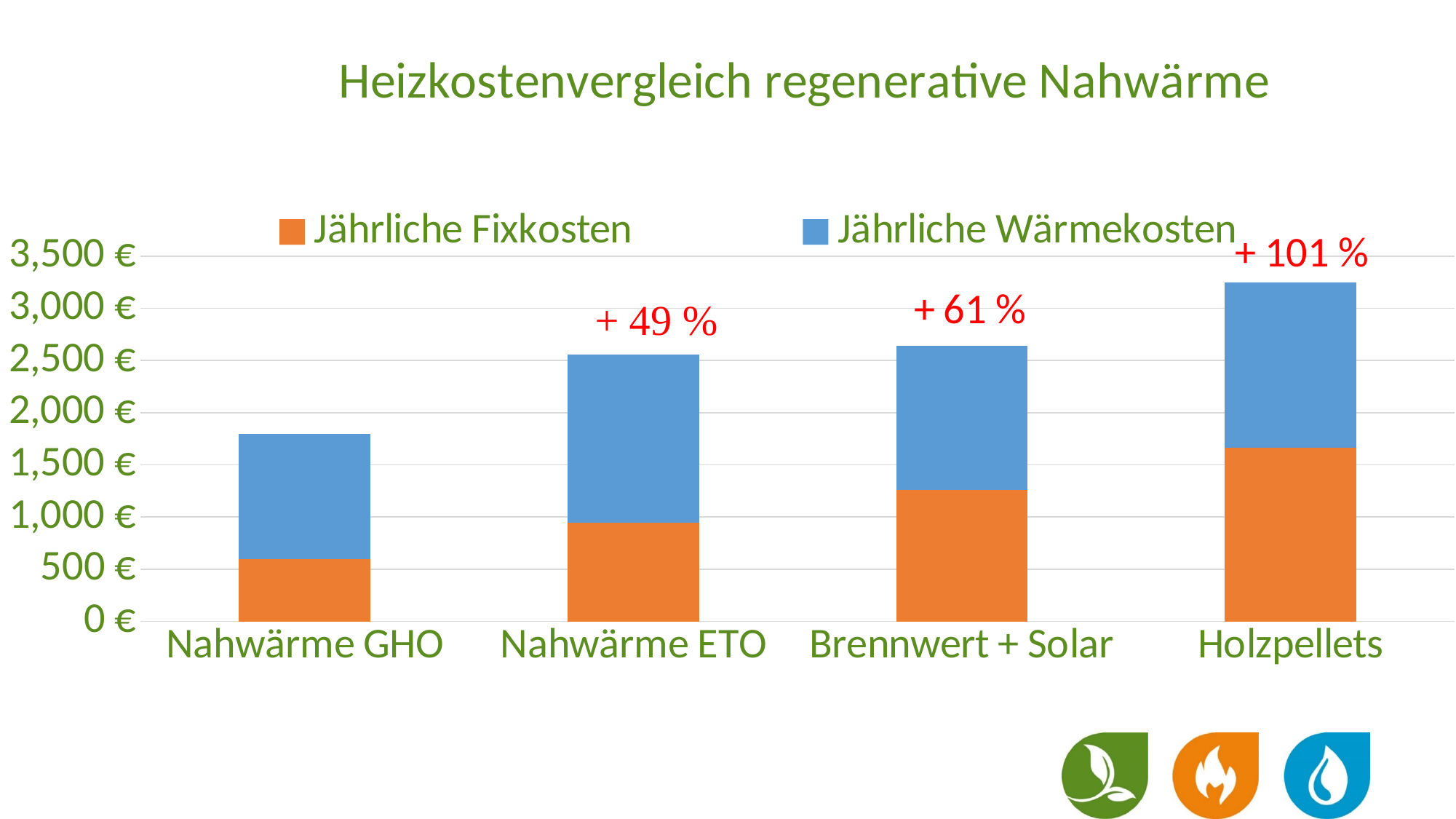
Do the total annual costs rise or fall from Nahwärme GHO to Holzpellets along the x axis? rise What percentage label is printed above the Holzpellets bar? + 101 % Which category has the lowest total annual cost? Nahwärme GHO What is the title of the chart? Heizkostenvergleich regenerative Nahwärme What kind of chart is shown on the slide? stacked bar chart Is the total value for Nahwärme GHO greater or less than 2,000 €? less What percentage label is printed above the Nahwärme ETO bar? + 49 % How many categories are shown on the x axis? 4 Is the Jährliche Fixkosten value for Brennwert + Solar greater or less than 1,000 €? greater How many series does the legend list? 2 Which category has the highest total annual cost? Holzpellets Is the total value for Holzpellets greater or less than 3,000 €? greater